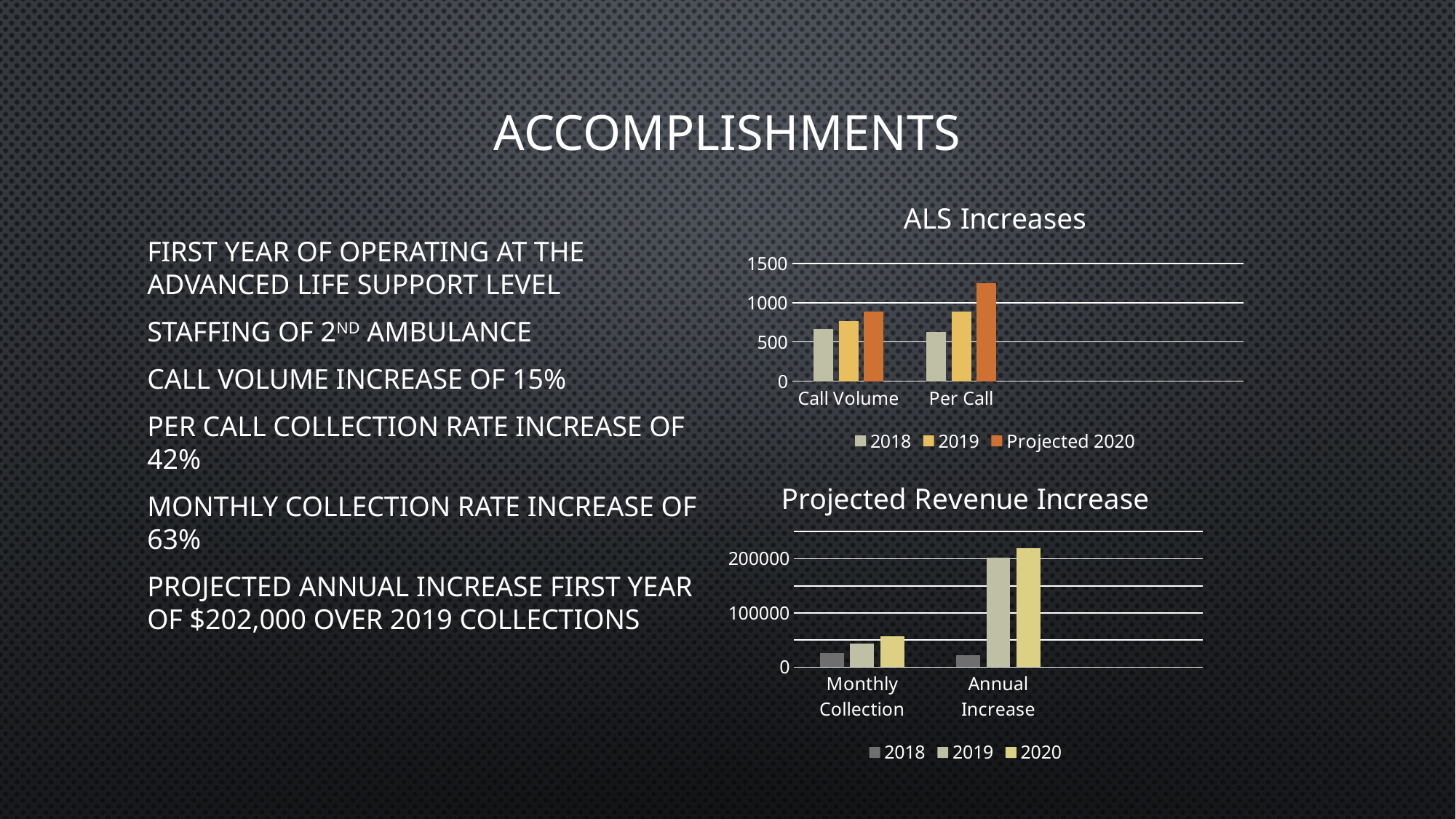
In the ALS Increases chart, do the Per Call values rise or fall from 2018 to Projected 2020? rise In the ALS Increases chart, which is larger for Projected 2020: Call Volume or Per Call? Per Call In the Projected Revenue Increase chart, is the 2020 value for Monthly Collection greater or less than 100000? less In the Projected Revenue Increase chart, how many categories are shown on the x axis? 2 In the ALS Increases chart, how many series does the legend list? 3 In the ALS Increases chart, is the 2018 value for Call Volume greater or less than 500? greater In the ALS Increases chart, is the Projected 2020 value for Call Volume greater or less than 1000? less What kind of chart is the Projected Revenue Increase chart? bar chart In the ALS Increases chart, which category and series has the tallest bar? Per Call, Projected 2020 In the Projected Revenue Increase chart, which is larger for 2019: Monthly Collection or Annual Increase? Annual Increase In the Projected Revenue Increase chart, which category and series has the tallest bar? Annual Increase, 2020